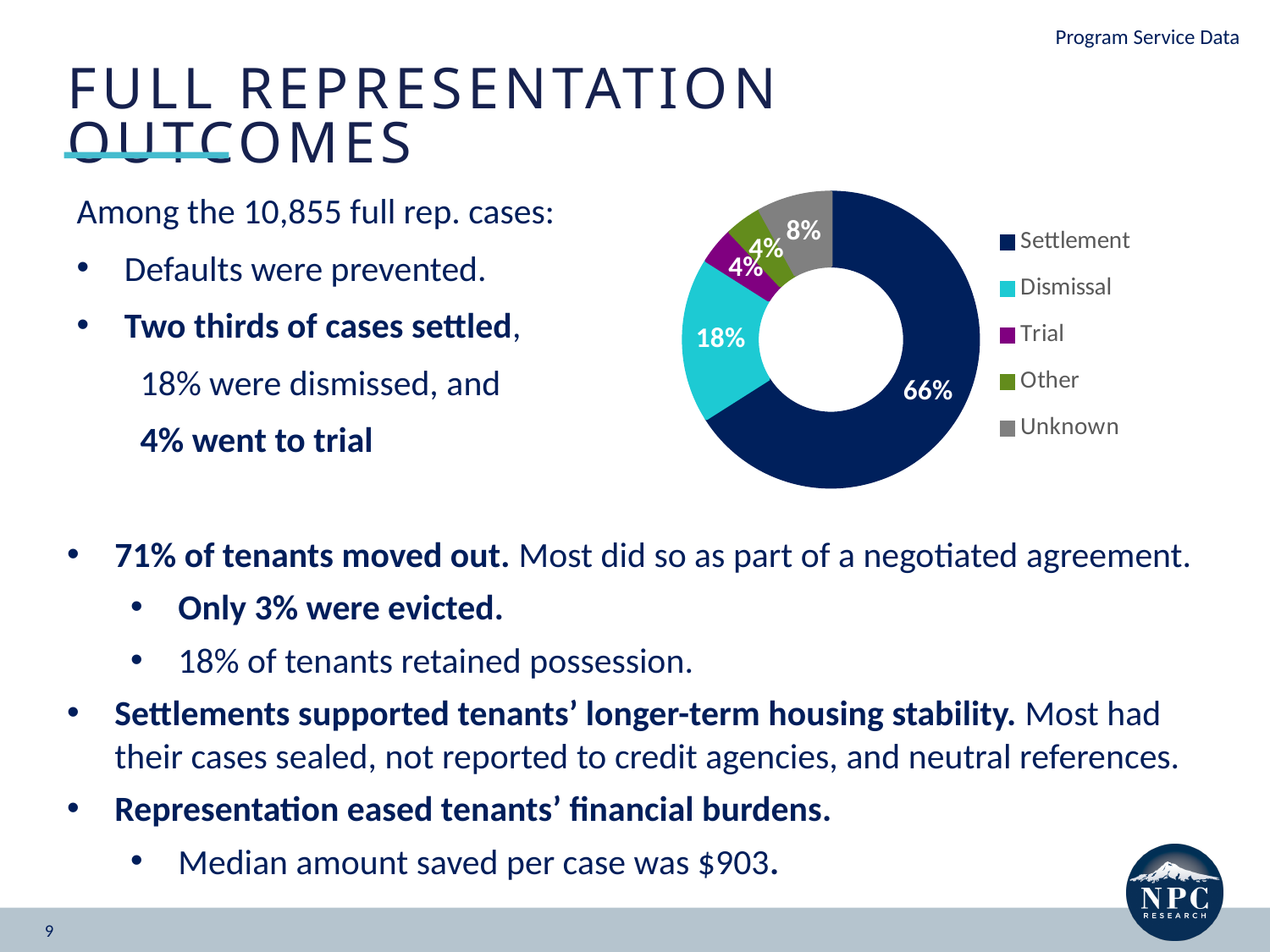
What percentage of cases ended in Dismissal? 18% How many categories does the chart's legend list? 5 Which legend entry is shown in grey? Unknown What share of full representation cases ended in Settlement? 66% What kind of chart is shown on the slide? Pie chart (donut) Which is larger, the share for Dismissal or the share for Unknown? Dismissal What colour represents Dismissal in the chart? Light blue Which outcome category has the largest share of the chart? Settlement What percentage of cases is labelled Unknown in the chart? 8% What is the difference in percentage points between the Settlement and Dismissal shares? 48 What is the difference in percentage points between the Unknown and Trial shares? 4 What percentage of cases went to Trial according to the chart? 4%